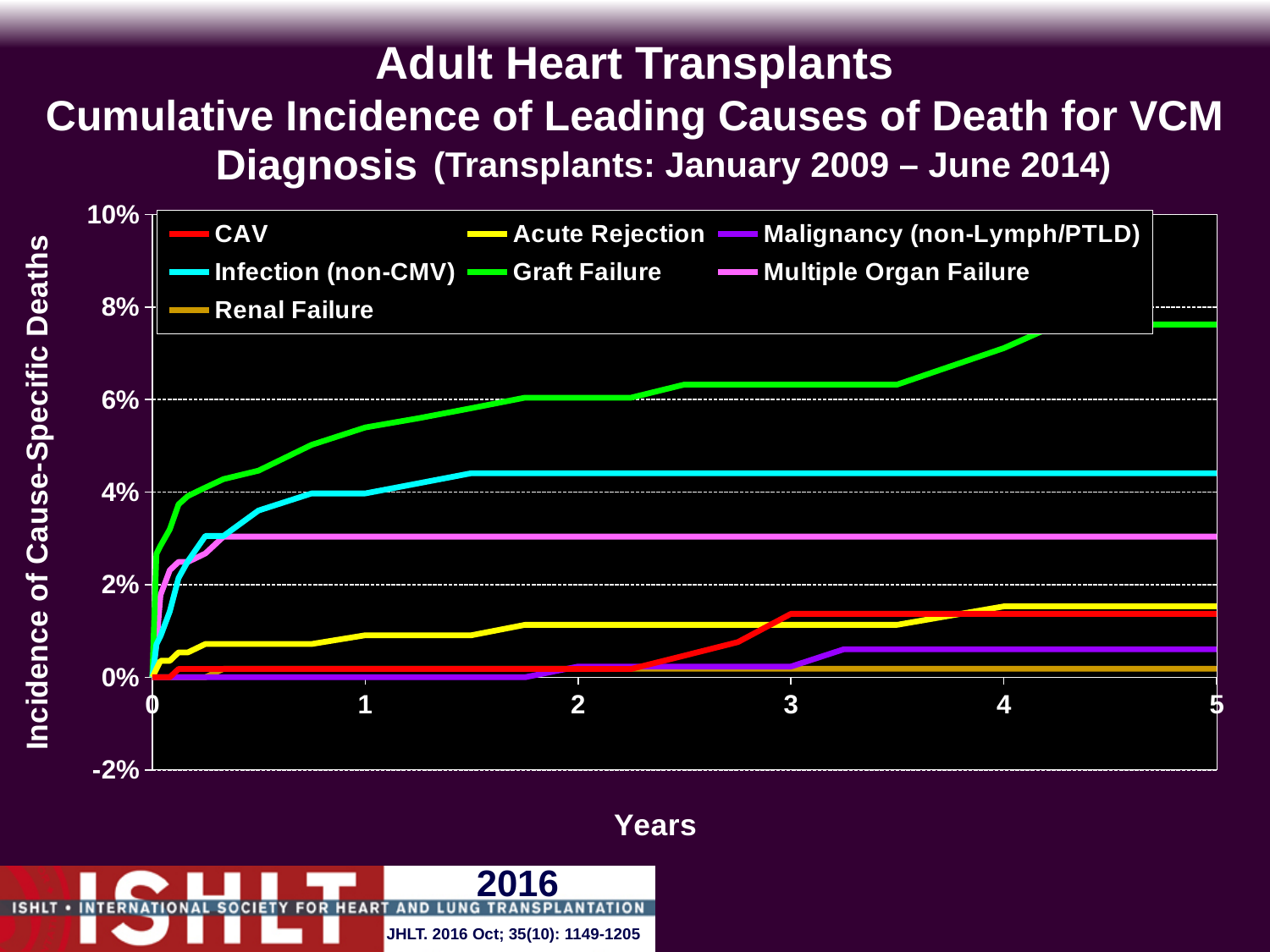
Is the cumulative incidence for Graft Failure at 5 years greater or less than 6%? greater What is the label of the x axis? Years Is the cumulative incidence for Multiple Organ Failure at 5 years greater or less than 2%? greater Which cause of death has the highest cumulative incidence at 5 years? Graft Failure Which cause of death has the lowest cumulative incidence at 5 years? Renal Failure At 5 years, which has the higher cumulative incidence: Infection (non-CMV) or Multiple Organ Failure? Infection (non-CMV) Is the cumulative incidence for Multiple Organ Failure at 5 years greater or less than 4%? less How many series does the legend list? 7 Does the cumulative incidence for Graft Failure rise or fall as years increase? rise What is the label of the y axis? Incidence of Cause-Specific Deaths What kind of chart is shown on the slide? line chart